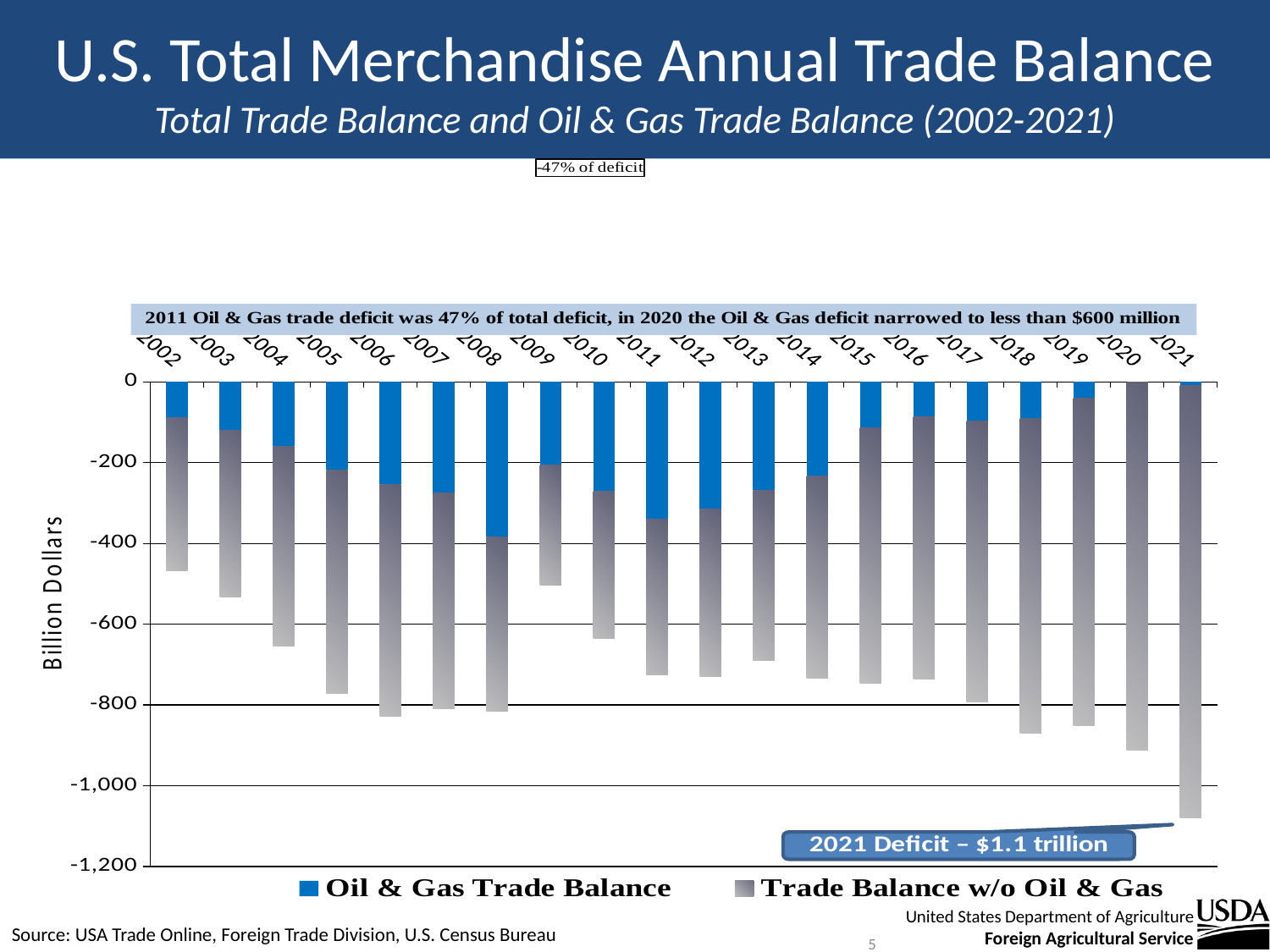
Is the total trade balance for 2002 greater or less than -600 billion dollars? greater What are the two series named in the chart legend? Oil & Gas Trade Balance; Trade Balance w/o Oil & Gas How many years are plotted along the x axis of the chart? 20 What kind of chart is shown on the slide? Stacked bar chart What is the label on the vertical axis of the chart? Billion Dollars How many series does the chart legend list? 2 Is the total trade balance for 2021 greater or less than -1,000 billion dollars? less According to the callout on the chart, what was the 2021 deficit? $1.1 trillion Which year has the largest total trade deficit (longest bar) in the chart? 2021 Which year has the largest Oil & Gas Trade Balance deficit (longest blue segment)? 2008 Which year has the larger total trade deficit, 2020 or 2021? 2021 According to the annotation on the chart, what share of the total deficit was the Oil & Gas trade deficit in 2011? 47%